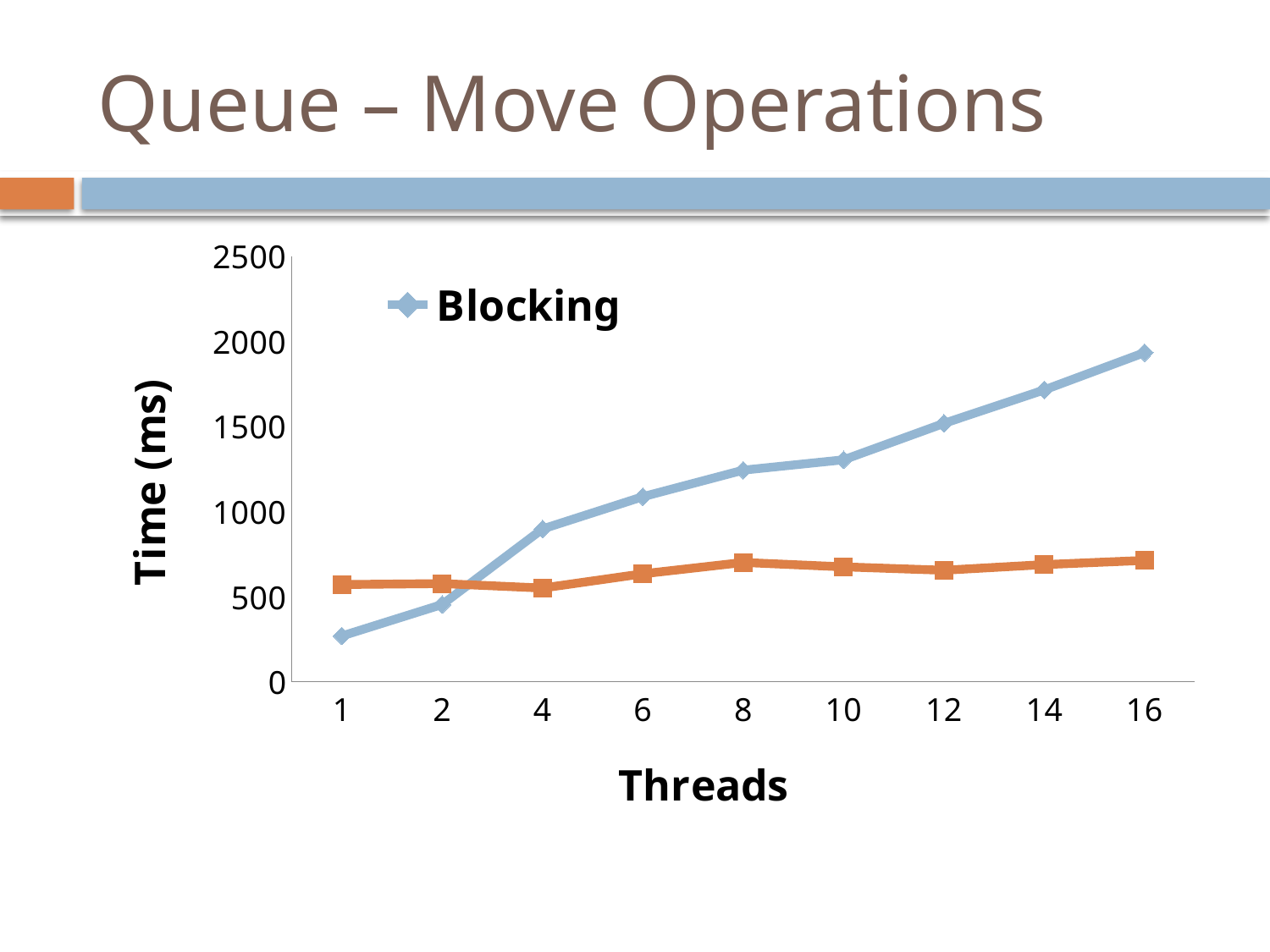
Is the Blocking value at 16 threads greater or less than 1500? greater How many series does the legend list? 1 At which number of threads is the Blocking series lowest? 1 At which number of threads is the Blocking series highest? 16 Is the Blocking value at 1 thread greater or less than 500? less Does the Blocking series rise or fall as the number of threads increases? rises What is the label on the y axis of the chart? Time (ms) Is the Blocking value at 8 threads greater or less than 1000? greater At 16 threads, which line is higher: the blue Blocking line or the orange line? the blue Blocking line What kind of chart is shown on the slide? line chart How many thread counts are plotted along the x axis? 9